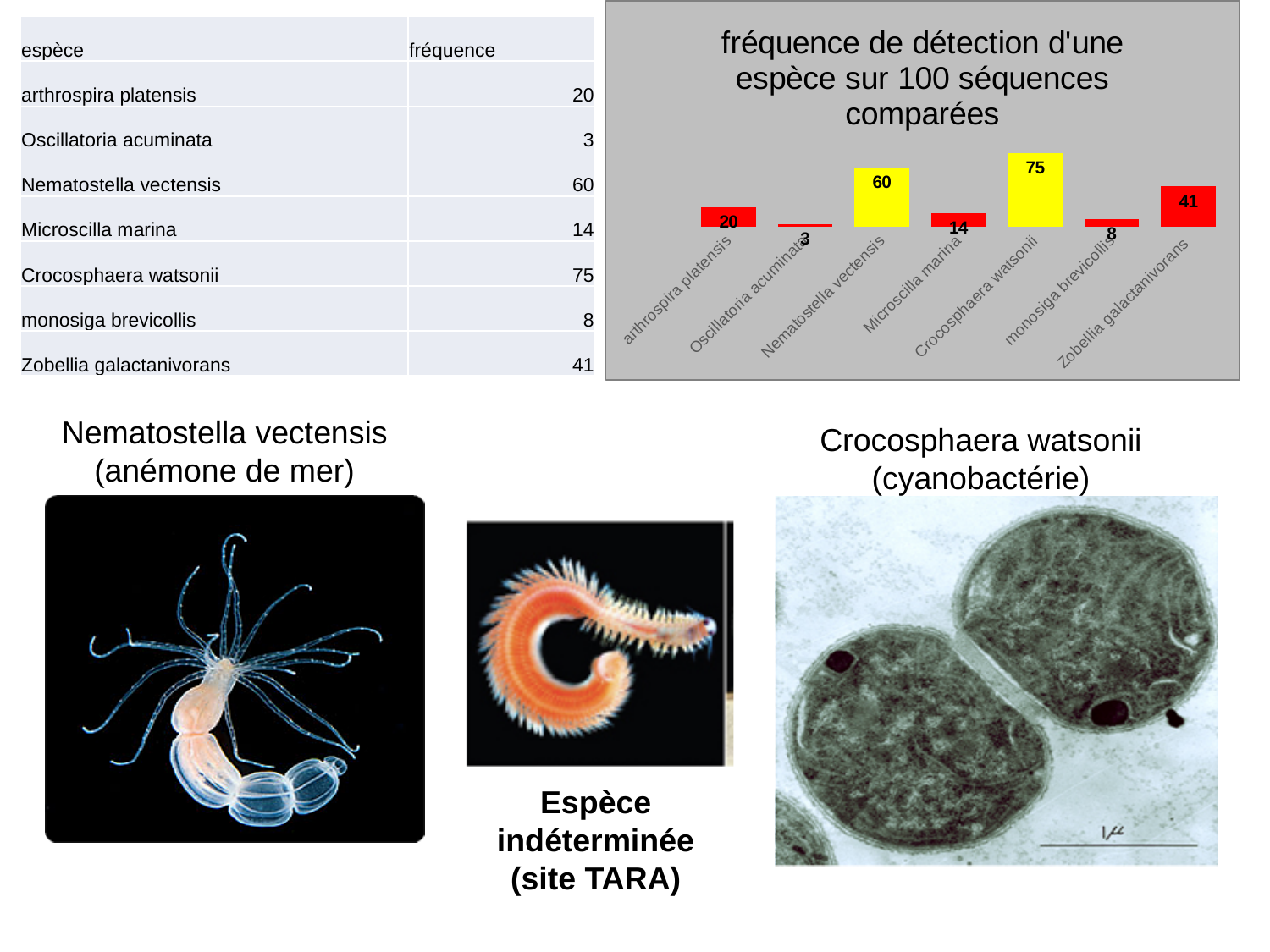
What is the value for Nematostella vectensis in the chart? 60 Which is larger, the value for Zobellia galactanivorans or the value for arthrospira platensis? Zobellia galactanivorans How many species are shown in the chart? 7 What kind of chart is shown on the slide? bar chart What is the difference between the values for arthrospira platensis and monosiga brevicollis? 12 What is the value for Oscillatoria acuminata in the chart? 3 Which species has the highest value in the chart? Crocosphaera watsonii What is the difference between the values for Crocosphaera watsonii and Nematostella vectensis? 15 What is the value for Crocosphaera watsonii in the chart? 75 What is the title of the chart? fréquence de détection d'une espèce sur 100 séquences comparées What is the value for Zobellia galactanivorans in the chart? 41 Which species has the lowest value in the chart? Oscillatoria acuminata